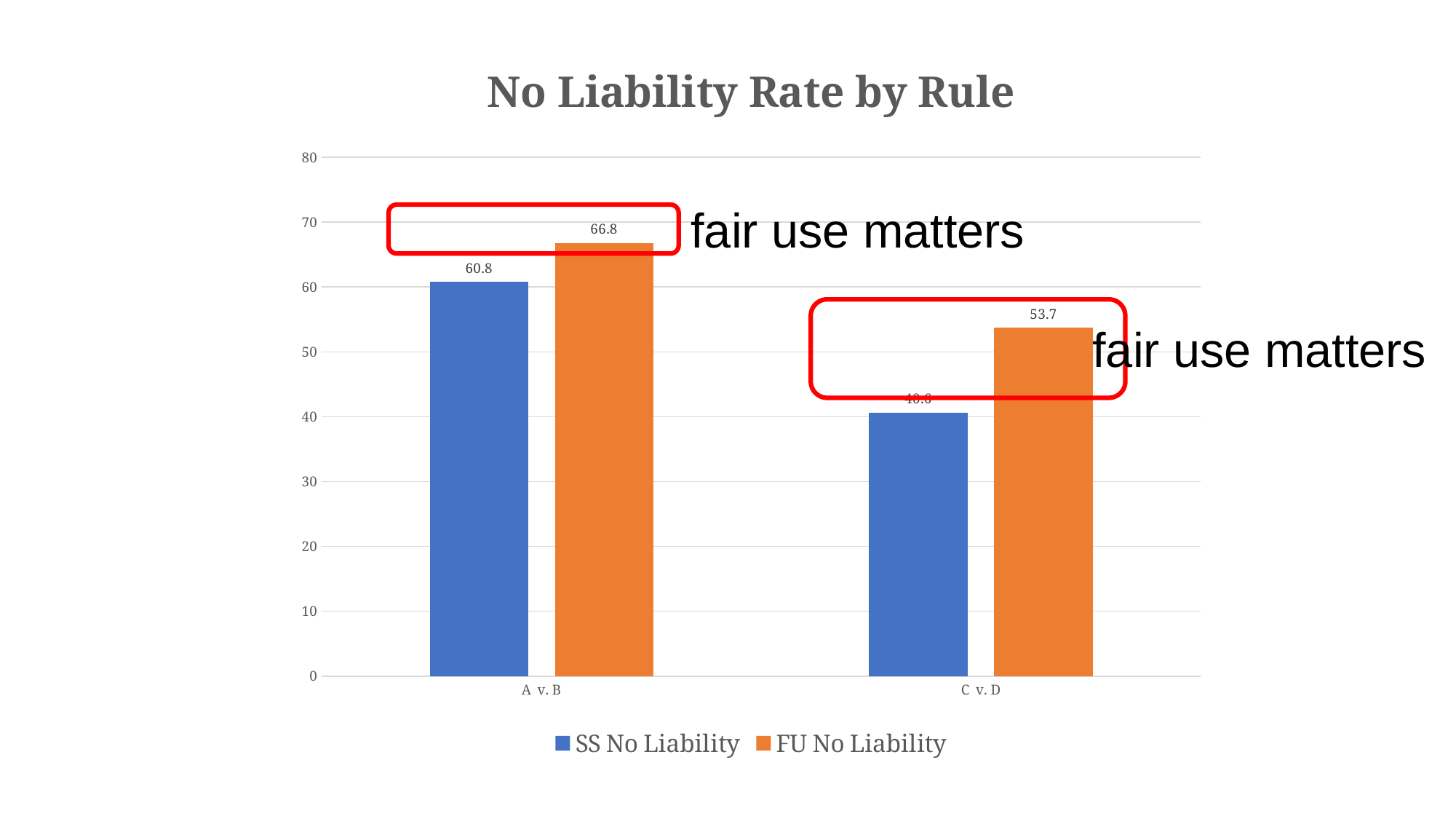
Which category has the highest FU No Liability value? A v. B How many categories are shown on the x axis? 2 What is the title of the chart? No Liability Rate by Rule For C v. D, which is larger: SS No Liability or FU No Liability? FU No Liability What is the FU No Liability value for A v. B? 66.8 What is the difference between the FU No Liability and SS No Liability values for A v. B? 6 What is the SS No Liability value for A v. B? 60.8 Is the SS No Liability value for C v. D greater or less than 50? less How many series does the legend list? 2 What kind of chart is shown on the slide? bar chart What is the FU No Liability value for C v. D? 53.7 Which category has the lowest SS No Liability value? C v. D